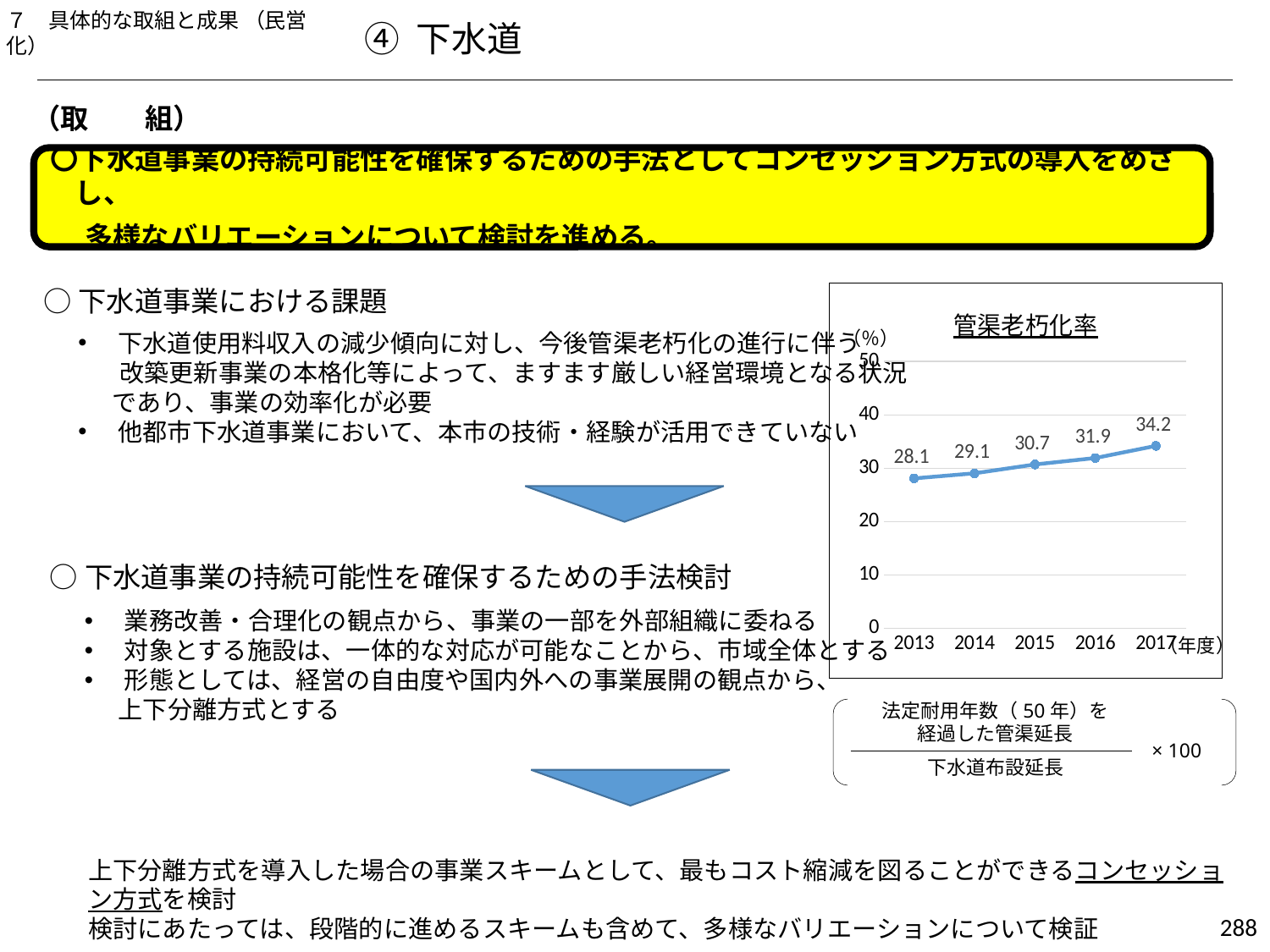
Which is larger in the 管渠老朽化率 chart, the value for 2014 or the value for 2016? 2016 Is the value for 2017 in the 管渠老朽化率 chart greater or less than 40? less How many data points are plotted in the 管渠老朽化率 chart? 5 What is the value for 2015 in the 管渠老朽化率 chart? 30.7 What is the difference between the 2017 and 2013 values in the 管渠老朽化率 chart? 6.1 What kind of chart is the 管渠老朽化率 chart? line chart What unit is shown on the vertical axis of the 管渠老朽化率 chart? % What is the value for 2013 in the 管渠老朽化率 chart? 28.1 Which year has the highest value in the 管渠老朽化率 chart? 2017 Do the values in the 管渠老朽化率 chart rise or fall from 2013 to 2017? rise What is the value for 2017 in the 管渠老朽化率 chart? 34.2 Which year has the lowest value in the 管渠老朽化率 chart? 2013